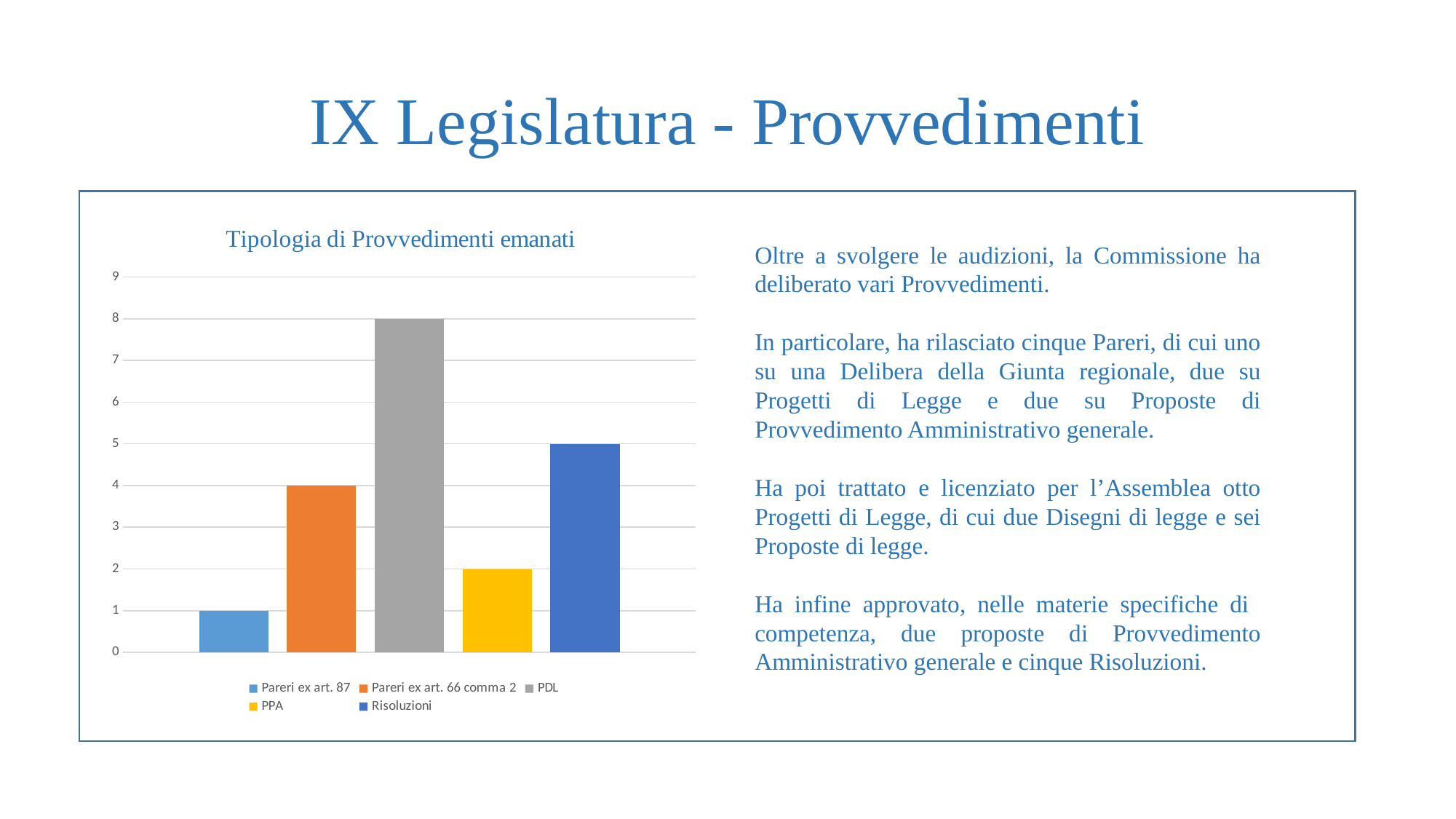
What is the title of the chart? Tipologia di Provvedimenti emanati What is the value for PPA in the chart? 2 What is the value for PDL in the chart? 8 What kind of chart is shown on the slide? Bar chart Which is larger, the value for Pareri ex art. 66 comma 2 or the value for PPA? Pareri ex art. 66 comma 2 Is the value for Risoluzioni greater or less than 3? greater Which category has the highest value in the chart? PDL How many entries does the chart legend list? 5 What is the difference between the values for PDL and Risoluzioni? 3 What is the value for Risoluzioni in the chart? 5 Which category has the lowest value in the chart? Pareri ex art. 87 What is the value for Pareri ex art. 87 in the chart? 1